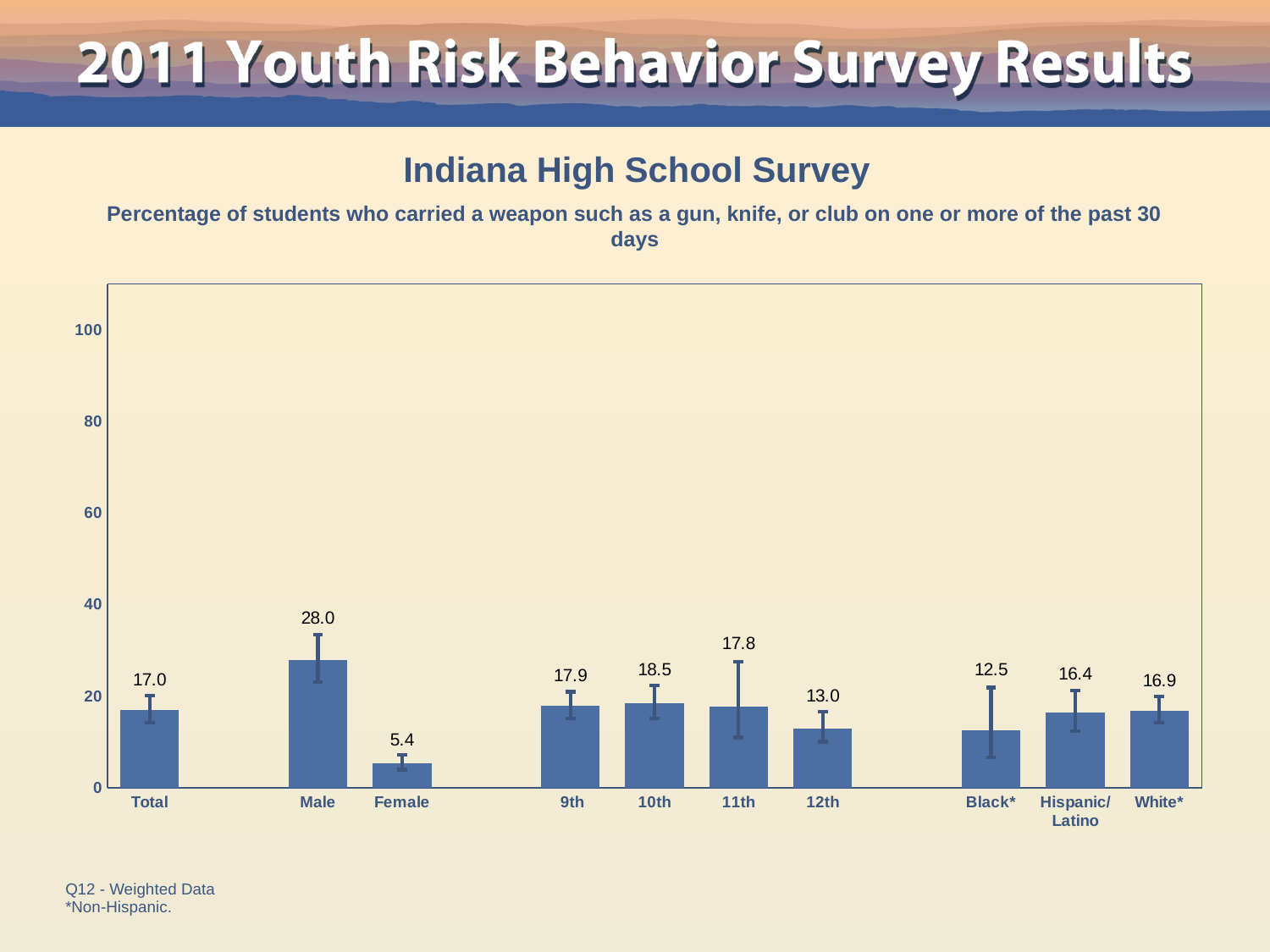
What is the value for 12th? 13.0 Is the value for Male greater or less than 20? greater Which is larger, the value for 10th or the value for 12th? 10th What is the value for Hispanic/Latino? 16.4 Which category has the lowest value? Female What is the value for Female? 5.4 What is the value for Total? 17.0 What is the difference between the values for Male and Female? 22.6 How many categories are shown on the x axis? 10 What kind of chart is this? bar chart Which category has the highest value? Male What is the value for Male? 28.0